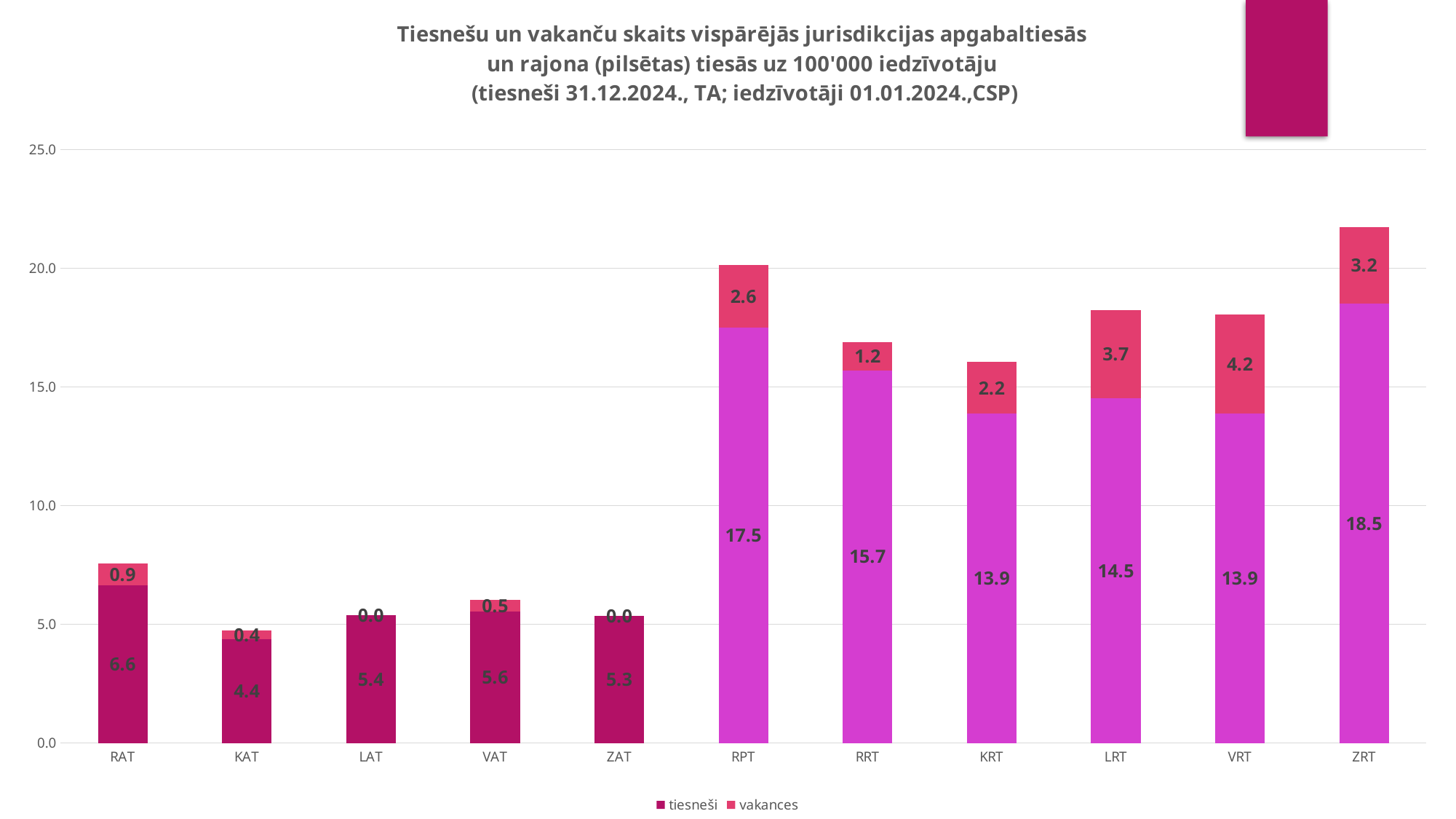
What is the tiesneši value for RPT? 17.5 Which is larger, the vakances value for LRT or for KRT? LRT What kind of chart is shown on the slide? Stacked bar chart Which category has the highest tiesneši value? ZRT How many categories are shown on the x axis? 11 What is the difference between the tiesneši values for ZRT and RPT? 1.0 Which category has the lowest tiesneši value? KAT What is the tiesneši value for KAT? 4.4 What is the vakances value for VRT? 4.2 What is the total of the stacked bar for ZRT? 21.7 How many series does the legend list? 2 Is the total stacked value for RPT greater or less than 20.0? greater